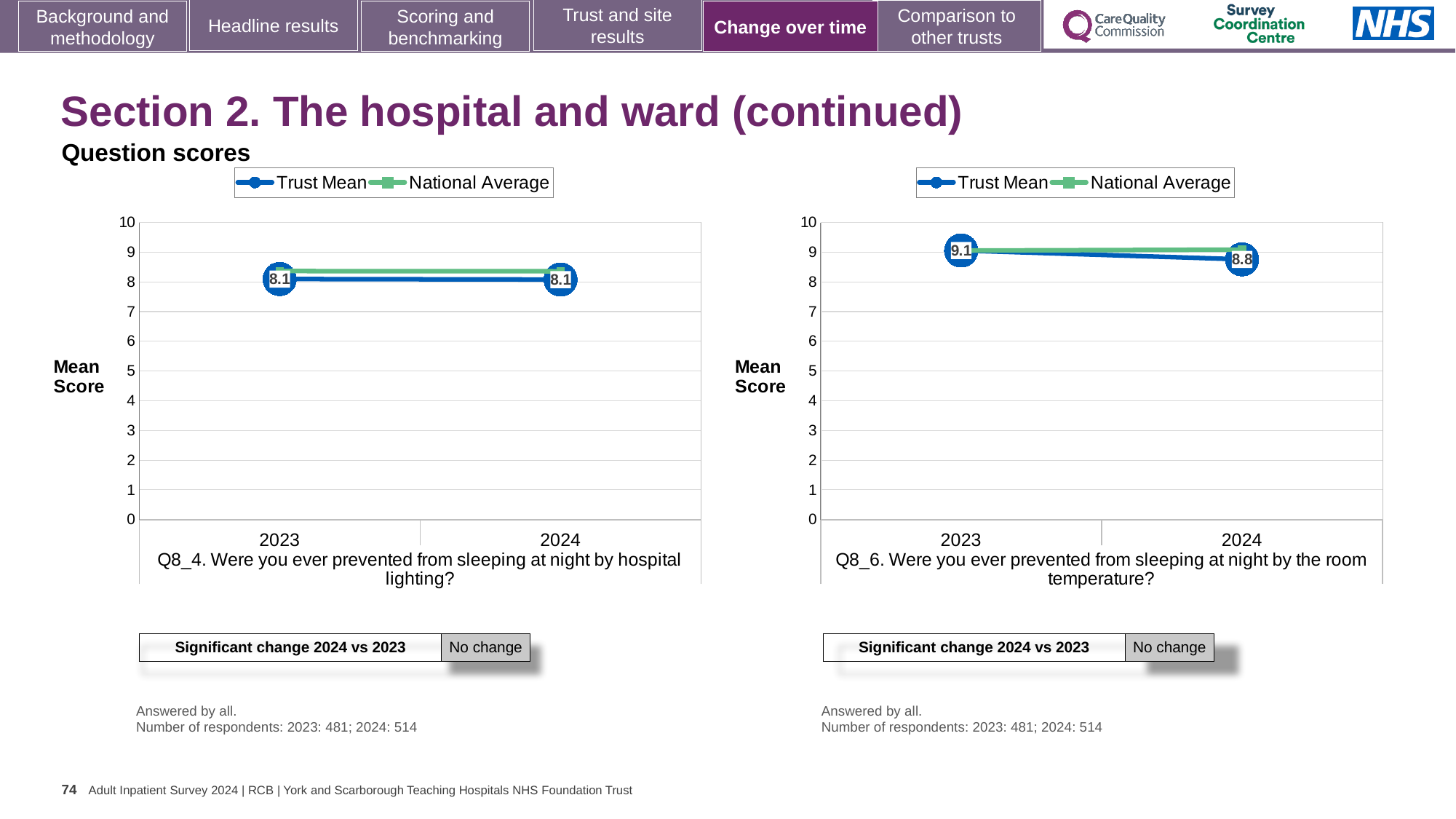
How many years are plotted on the x axis of the Q8_6 chart (right)? 2 In the Q8_6 chart (right), what is the Trust Mean score for 2024? 8.8 In the Q8_4 chart (left), what is the Trust Mean score for 2023? 8.1 In the Q8_4 chart (left), what is the Trust Mean score for 2024? 8.1 How many series does the legend of the Q8_6 chart (right) list? 2 In the Q8_4 chart (left), is the National Average value for 2024 greater or less than 8? greater In the Q8_6 chart (right), what is the Trust Mean score for 2023? 9.1 What kind of chart is the Q8_4 chart (left)? line chart In the Q8_6 chart (right), does the Trust Mean rise or fall from 2023 to 2024? fall In the Q8_4 chart (left), is the National Average value for 2023 greater or less than 9? less In the Q8_6 chart (right), which year has the higher Trust Mean score, 2023 or 2024? 2023 In the Q8_6 chart (right), what is the difference between the Trust Mean scores for 2023 and 2024? 0.3